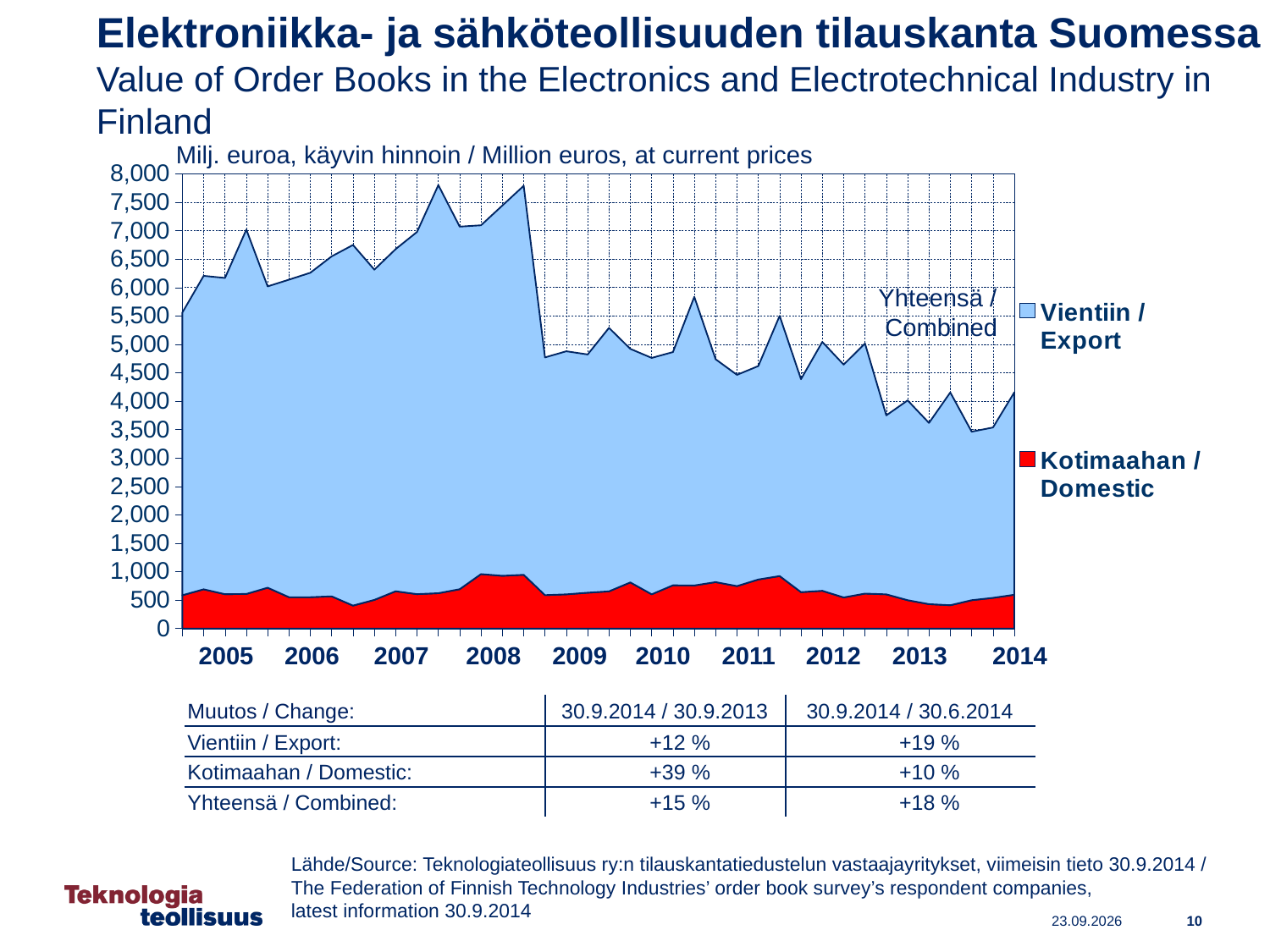
Which is larger in 2010, the Vientiin / Export area or the Kotimaahan / Domestic area? Vientiin / Export According to the table, what is the change for Kotimaahan / Domestic for 30.9.2014 / 30.9.2013? +39 % What unit is stated above the chart? Milj. euroa, käyvin hinnoin / Million euros, at current prices How many years are labelled on the x axis of the chart? 10 Is the combined (Yhteensä) value at its 2008 peak greater or less than 7,500? greater What kind of chart is shown on the slide? Stacked area chart According to the table, what is the change for Yhteensä / Combined for 30.9.2014 / 30.6.2014? +18 % Which series is shown in red in the chart? Kotimaahan / Domestic How many series does the chart legend list? 2 Does the combined order book value rise or fall between 2008 and 2009? fall Is the combined value in 2013 greater or less than 4,500? less